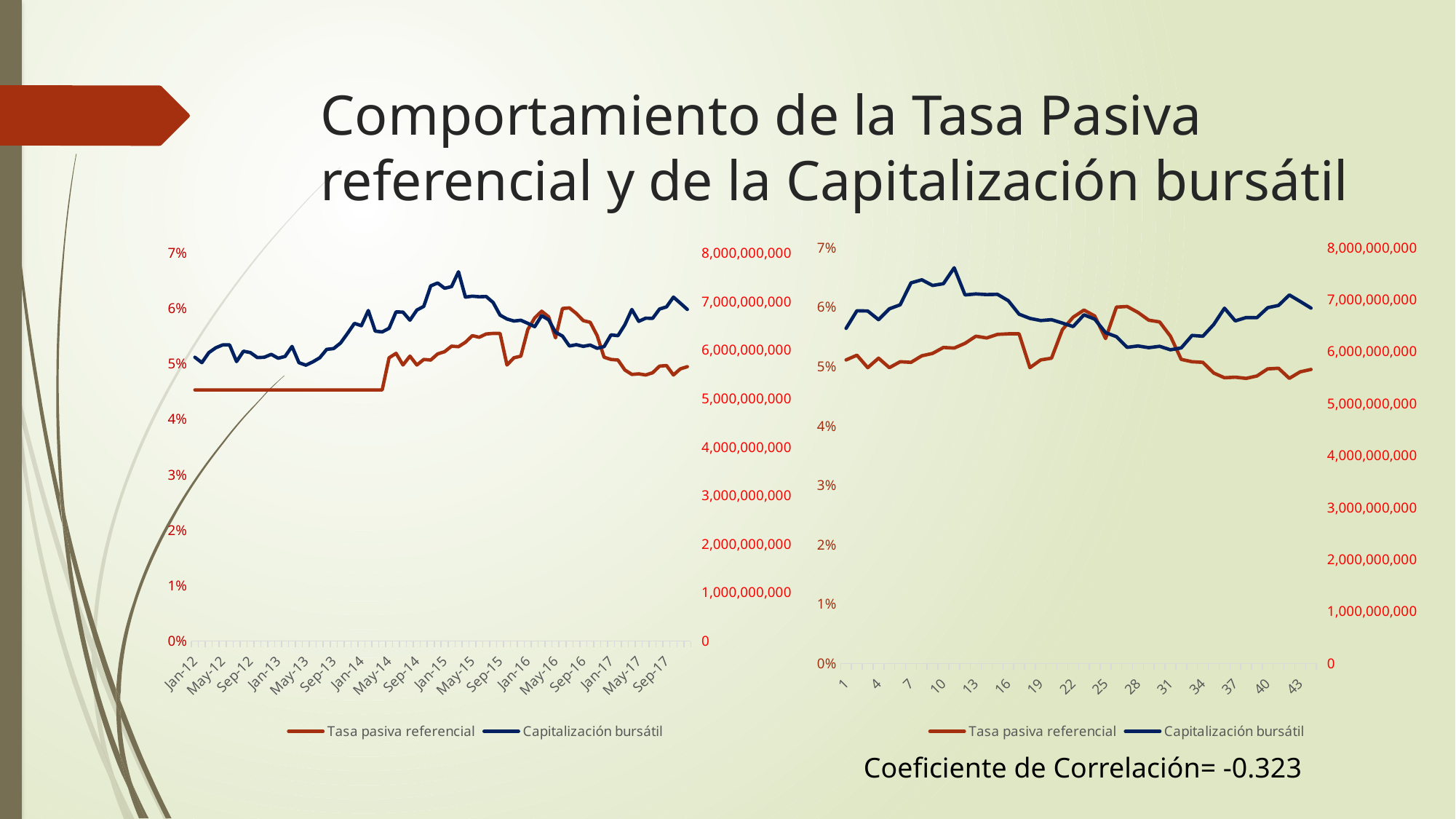
In the left chart, is the value of Capitalización bursátil at May-13 greater or less than 6,000,000,000? less How many series does the legend of the right chart list? 2 What correlation coefficient is stated below the right chart? -0.323 What is the highest value shown on the left-hand percentage axis of the left chart? 7% In the right chart, is the value of Tasa pasiva referencial at point 37 greater or less than 5%? less In the left chart, does Capitalización bursátil generally rise or fall from Jan-12 to May-15? rise In the right chart, is the value of Capitalización bursátil at point 10 greater or less than 7,000,000,000? greater In the left chart, does Tasa pasiva referencial generally rise or fall from May-16 to Sep-17? fall How many labelled ticks are shown on the x axis of the right chart? 15 What kind of chart is the left chart on the slide? line chart